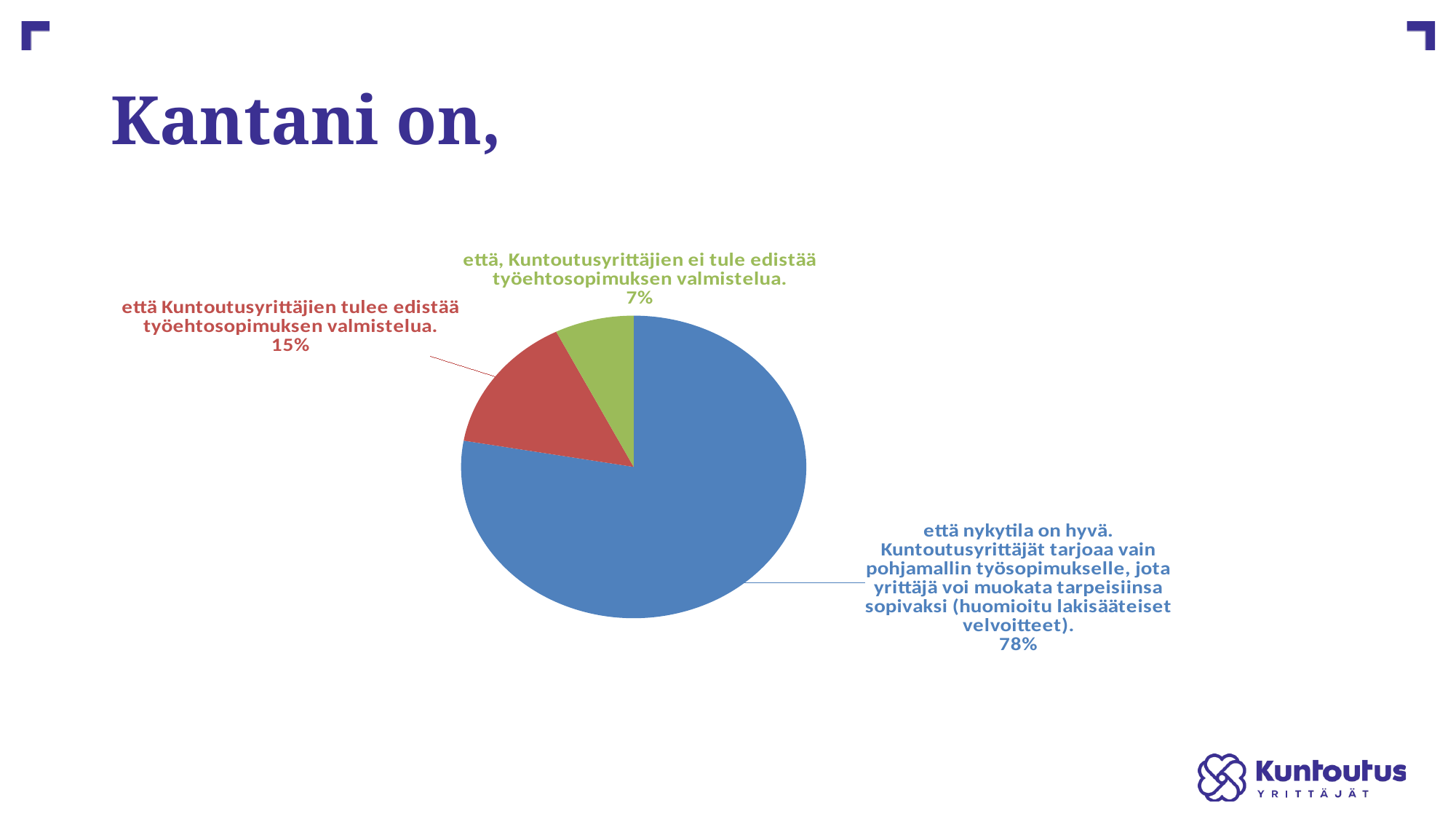
What share of the pie is labelled "että nykytila on hyvä..." (the blue slice)? 78% How many slices does the pie chart have? 3 Which is larger: the share for "tulee edistää työehtosopimuksen valmistelua" or the share for "ei tule edistää työehtosopimuksen valmistelua"? tulee edistää työehtosopimuksen valmistelua (15%) What colour is the slice representing 15%? red What share of the pie is labelled "että Kuntoutusyrittäjien tulee edistää työehtosopimuksen valmistelua."? 15% What is the title of the slide containing the pie chart? Kantani on, What share of the pie is labelled "että, Kuntoutusyrittäjien ei tule edistää työehtosopimuksen valmistelua."? 7% What type of chart is shown on the slide? pie chart Which slice of the pie chart is the smallest? että, Kuntoutusyrittäjien ei tule edistää työehtosopimuksen valmistelua. (7%) What is the difference in percentage points between the "tulee edistää" slice and the "ei tule edistää" slice? 8 What is the difference in percentage points between the 78% slice and the 15% slice? 63 Which slice of the pie chart is the largest? että nykytila on hyvä (78%)